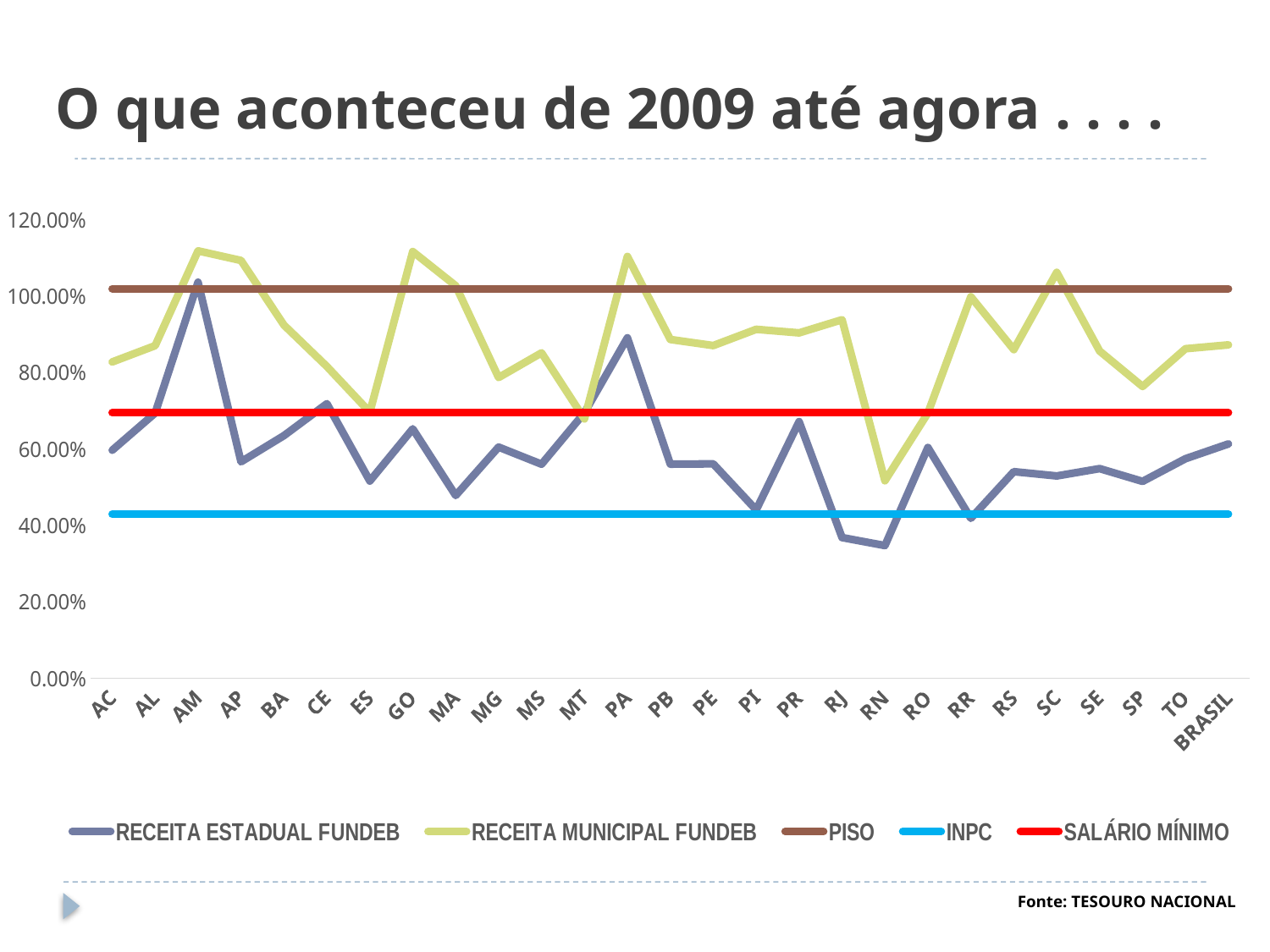
Which category has the lowest value for RECEITA ESTADUAL FUNDEB? RN What kind of chart is shown on the slide? line chart At AM, which is larger: RECEITA ESTADUAL FUNDEB or RECEITA MUNICIPAL FUNDEB? RECEITA MUNICIPAL FUNDEB Is the value for RECEITA MUNICIPAL FUNDEB at GO greater or less than 100.00%? greater How many series does the legend list? 5 Which series is drawn as a red horizontal line? SALÁRIO MÍNIMO What is the title of the slide containing the chart? O que aconteceu de 2009 até agora . . . . Is the value for RECEITA ESTADUAL FUNDEB at PA greater or less than 80.00%? greater Which category has the lowest value for RECEITA MUNICIPAL FUNDEB? RN Is the value for RECEITA ESTADUAL FUNDEB at RJ greater or less than 40.00%? less How many categories are shown along the x axis? 27 Which category has the highest value for RECEITA ESTADUAL FUNDEB? AM